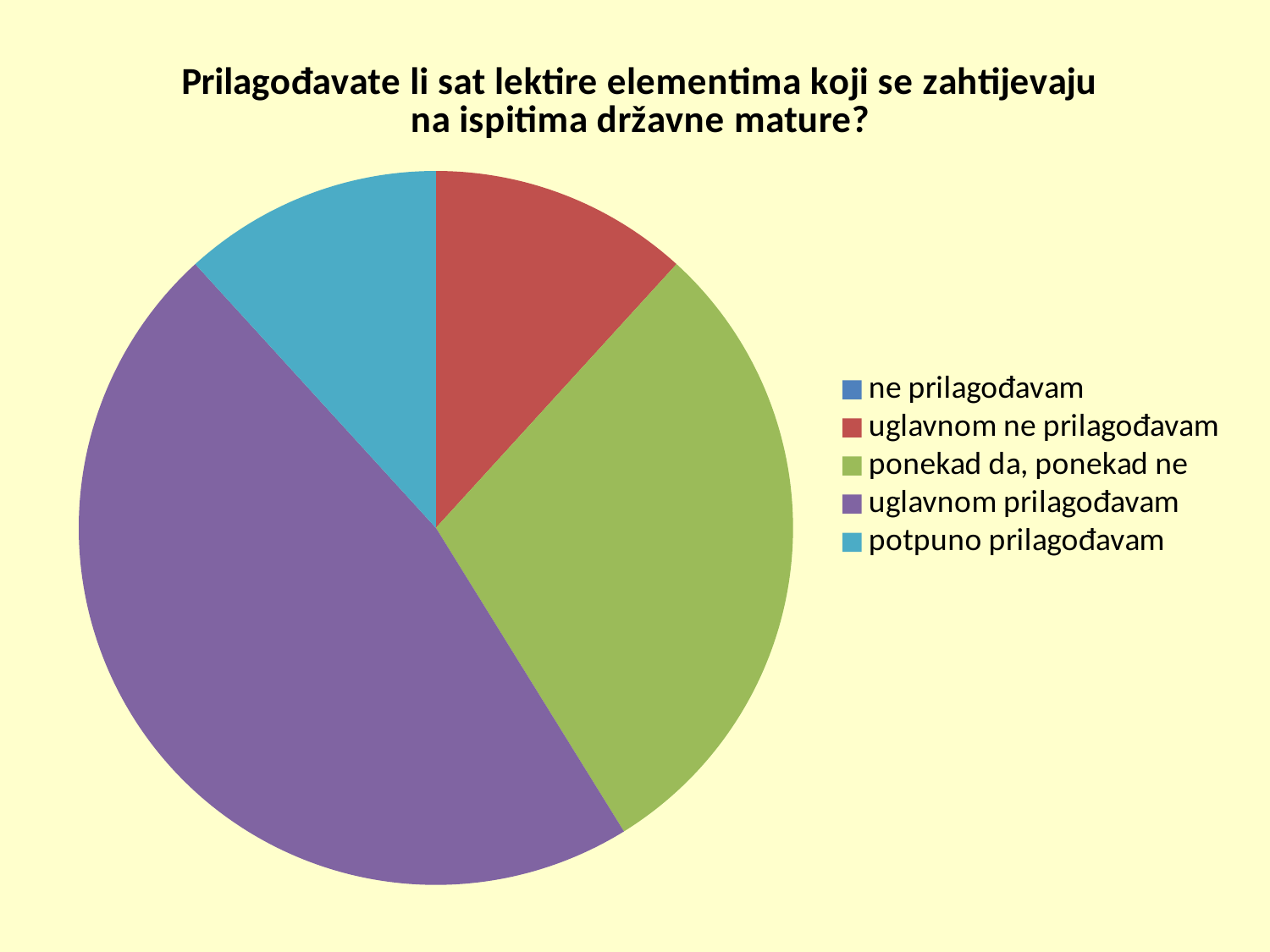
How many categories does the legend list? 5 What kind of chart is shown on the slide? pie chart How many slices are visible in the pie? 4 Which slice is larger, "uglavnom prilagođavam" or "ponekad da, ponekad ne"? uglavnom prilagođavam Which category has the largest slice of the pie? uglavnom prilagođavam What colour is the slice for "potpuno prilagođavam"? light blue Which category has the second-largest slice of the pie? ponekad da, ponekad ne Which slice is larger, "ponekad da, ponekad ne" or "uglavnom ne prilagođavam"? ponekad da, ponekad ne What is the title of the chart? Prilagođavate li sat lektire elementima koji se zahtijevaju na ispitima državne mature? Which slice is larger, "uglavnom prilagođavam" or "potpuno prilagođavam"? uglavnom prilagođavam